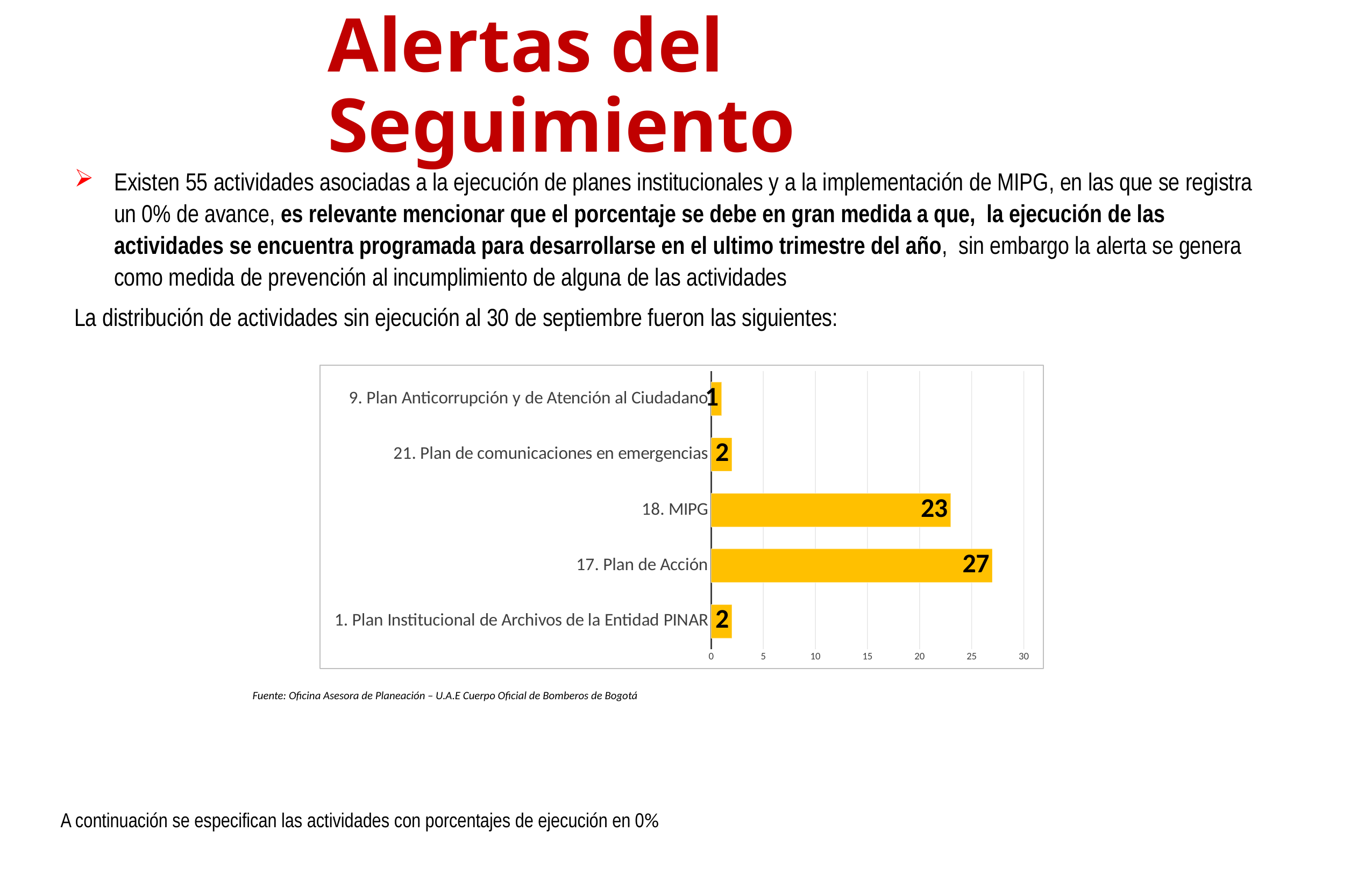
What is the value for 17. Plan de Acción? 27 What colour are the bars in the chart? yellow Which category has the highest value? 17. Plan de Acción Which category has the lowest value? 9. Plan Anticorrupción y de Atención al Ciudadano What is the value for 9. Plan Anticorrupción y de Atención al Ciudadano? 1 What is the difference between the values for 17. Plan de Acción and 18. MIPG? 4 How many categories are shown in the chart? 5 What kind of chart is shown on the slide? bar chart What is the value for 18. MIPG? 23 Which is larger, the value for 18. MIPG or the value for 21. Plan de comunicaciones en emergencias? 18. MIPG What is the value for 1. Plan Institucional de Archivos de la Entidad PINAR? 2 Is the value for 18. MIPG greater or less than 20? greater